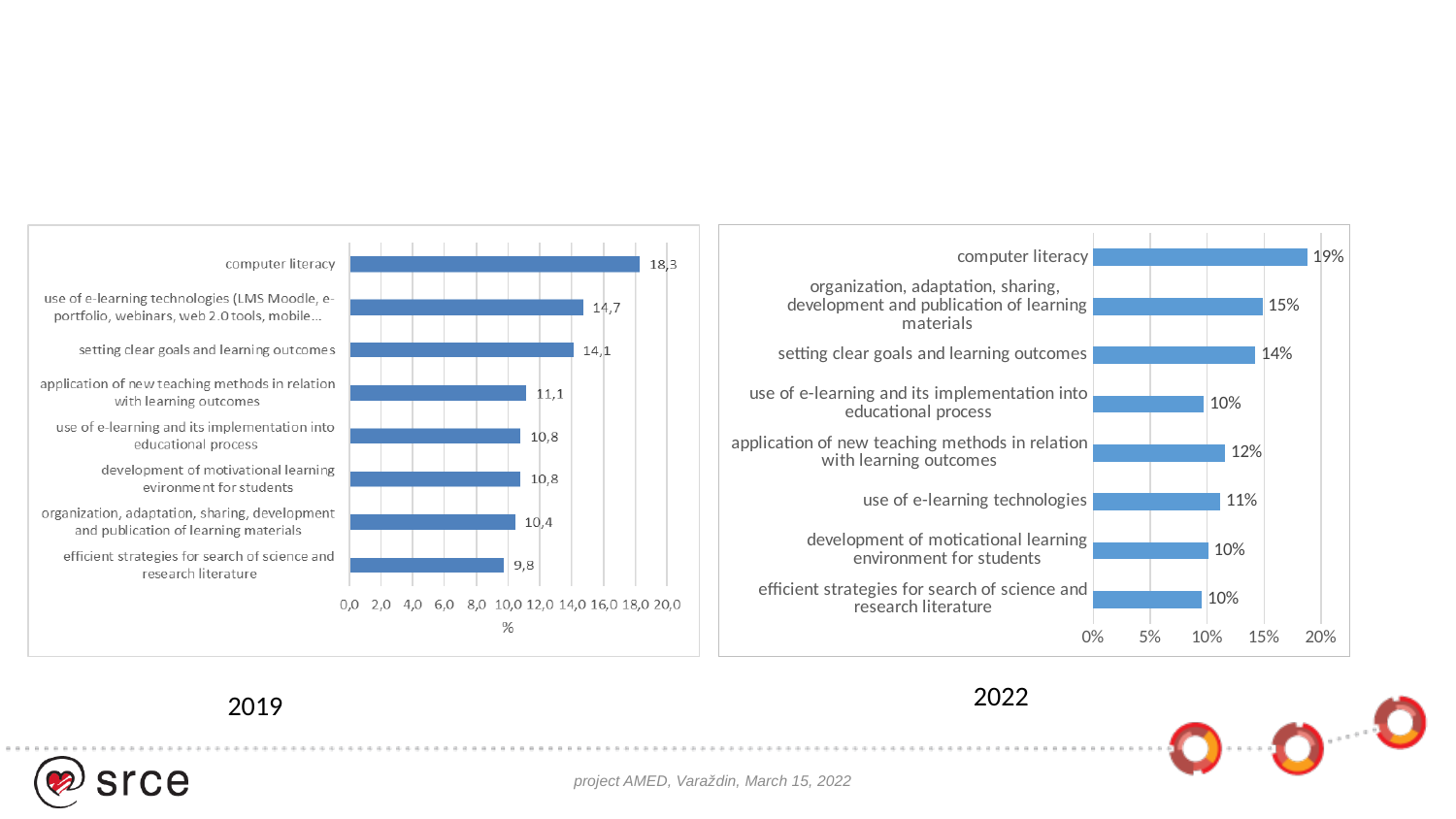
In the 2019 chart, how many categories are shown? 8 In the 2019 chart, which category has the lowest value? efficient strategies for search of science and research literature In the 2019 chart, what is the value for computer literacy? 18,3 What is the label of the x axis in the 2019 chart? % In the 2022 chart, what is the difference between computer literacy and efficient strategies for search of science and research literature? 9% In the 2022 chart, which is larger: setting clear goals and learning outcomes or use of e-learning technologies? setting clear goals and learning outcomes In the 2022 chart, what is the value for application of new teaching methods in relation with learning outcomes? 12% In the 2019 chart, what is the value for setting clear goals and learning outcomes? 14,1 In the 2022 chart, which category has the highest value? computer literacy What type of chart is the 2022 chart? bar chart In the 2019 chart, what is the difference between computer literacy and use of e-learning technologies? 3,6 In the 2022 chart, what is the value for organization, adaptation, sharing, development and publication of learning materials? 15%